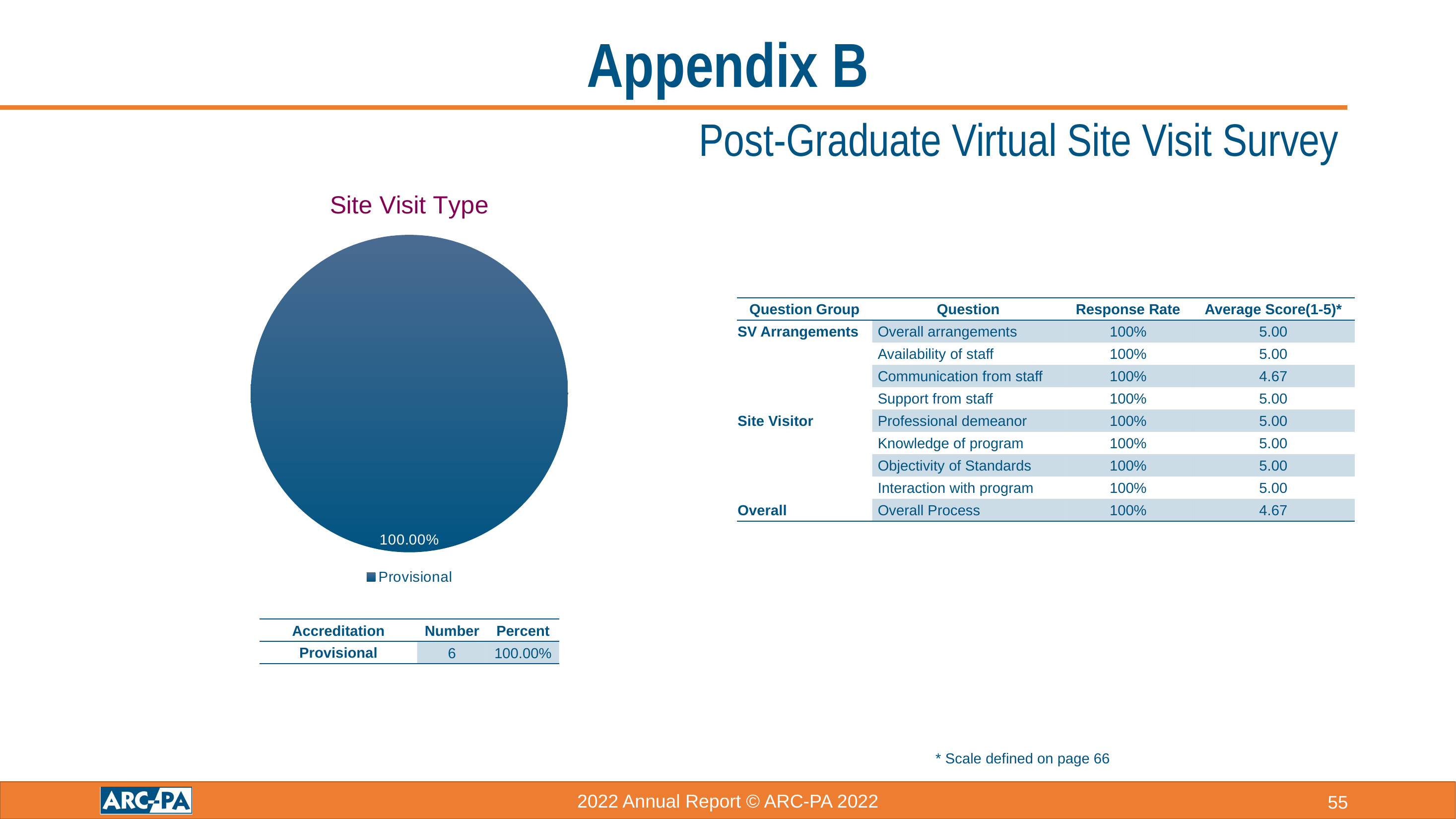
How many slices does the "Site Visit Type" pie chart have? 1 Which category has the largest slice in the "Site Visit Type" pie chart? Provisional What type of chart is the "Site Visit Type" chart? pie chart What share of the "Site Visit Type" pie chart does the Provisional slice represent? 100.00% What is the title of the pie chart on the slide? Site Visit Type What is the data label shown on the "Site Visit Type" pie chart? 100.00% Which category is shown in the legend of the "Site Visit Type" pie chart? Provisional How many entries does the legend of the "Site Visit Type" pie chart list? 1